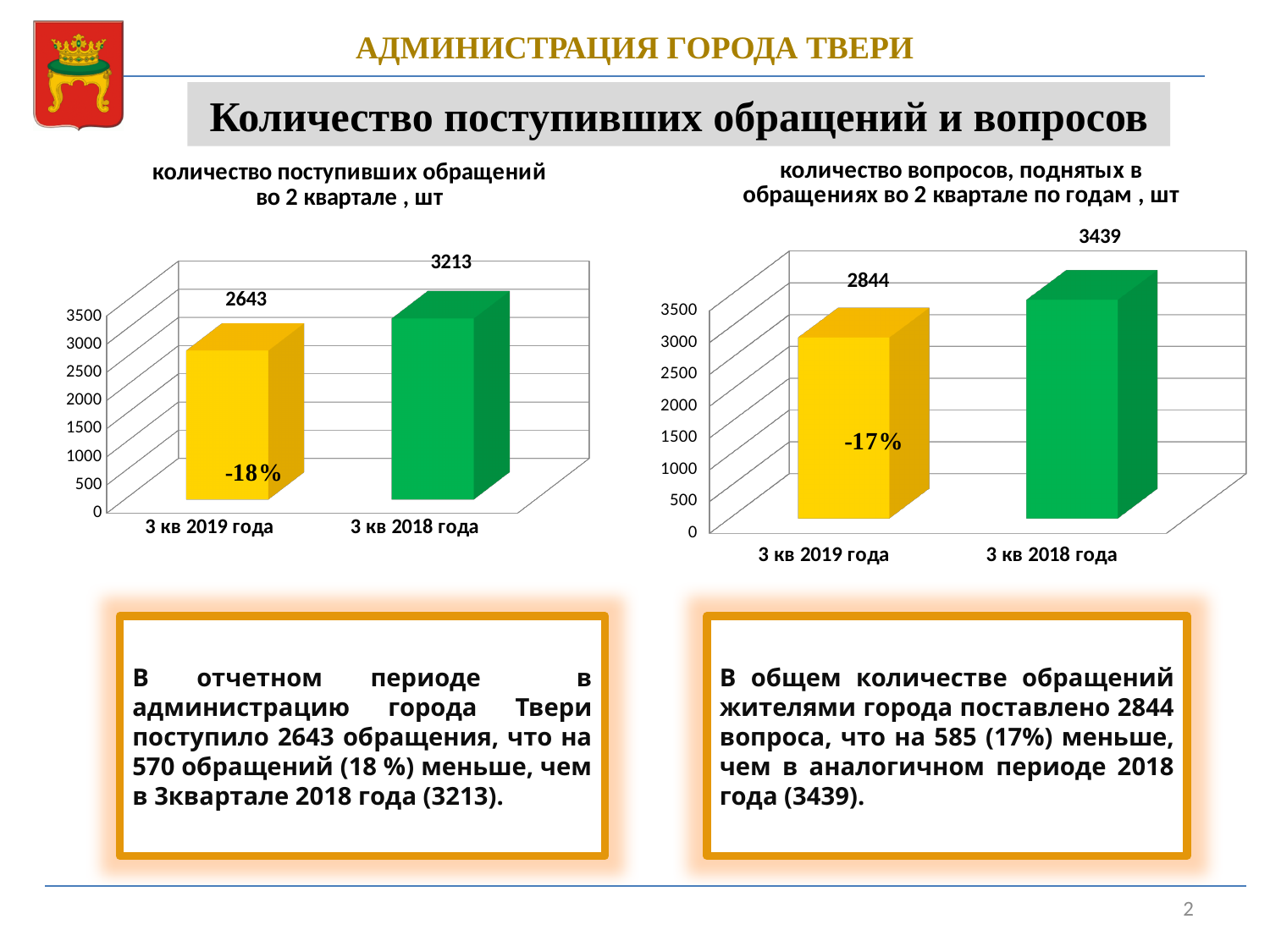
In the right chart, which is larger: the value for 3 кв 2019 года or 3 кв 2018 года? 3 кв 2018 года In the right chart, which category has the lowest value? 3 кв 2019 года In the left chart, which category has the highest value? 3 кв 2018 года In the left chart, is the value for 3 кв 2019 года greater or less than 3000? less In the left chart, what is the difference between the values for 3 кв 2018 года and 3 кв 2019 года? 570 What type of chart is the left chart? bar chart In the left chart, what is the value for 3 кв 2019 года? 2643 How many categories are shown in the right chart? 2 In the right chart, what is the value for 3 кв 2018 года? 3439 In the left chart, what is the value for 3 кв 2018 года? 3213 In the right chart, what is the difference between the values for 3 кв 2018 года and 3 кв 2019 года? 595 In the right chart, what is the value for 3 кв 2019 года? 2844